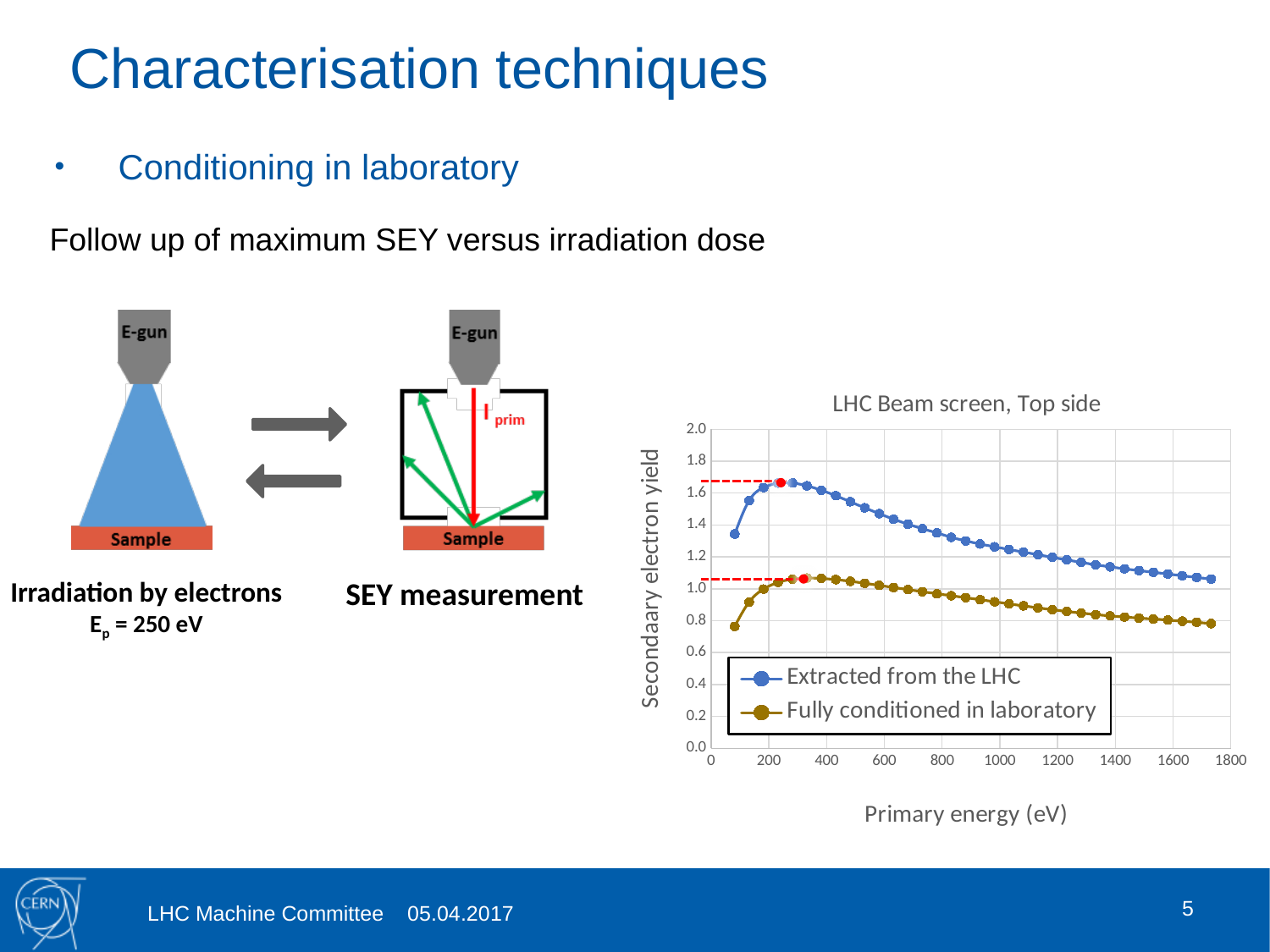
What is the title of the chart? LHC Beam screen, Top side Is the peak secondary electron yield of the 'Fully conditioned in laboratory' series greater or less than 1.2? less At a primary energy of 1000 eV, which series has the higher secondary electron yield? Extracted from the LHC What kind of chart is shown on the slide? Line chart How many series does the chart legend list? 2 Does the secondary electron yield of the 'Extracted from the LHC' series rise or fall as primary energy increases from 400 eV to 1800 eV? fall Which series lies below the other across the whole energy range? Fully conditioned in laboratory What is the label of the x axis of the chart? Primary energy (eV) Is the secondary electron yield of the 'Extracted from the LHC' series at 1000 eV greater or less than 1.0? greater Is the peak secondary electron yield of the 'Extracted from the LHC' series greater or less than 1.6? greater